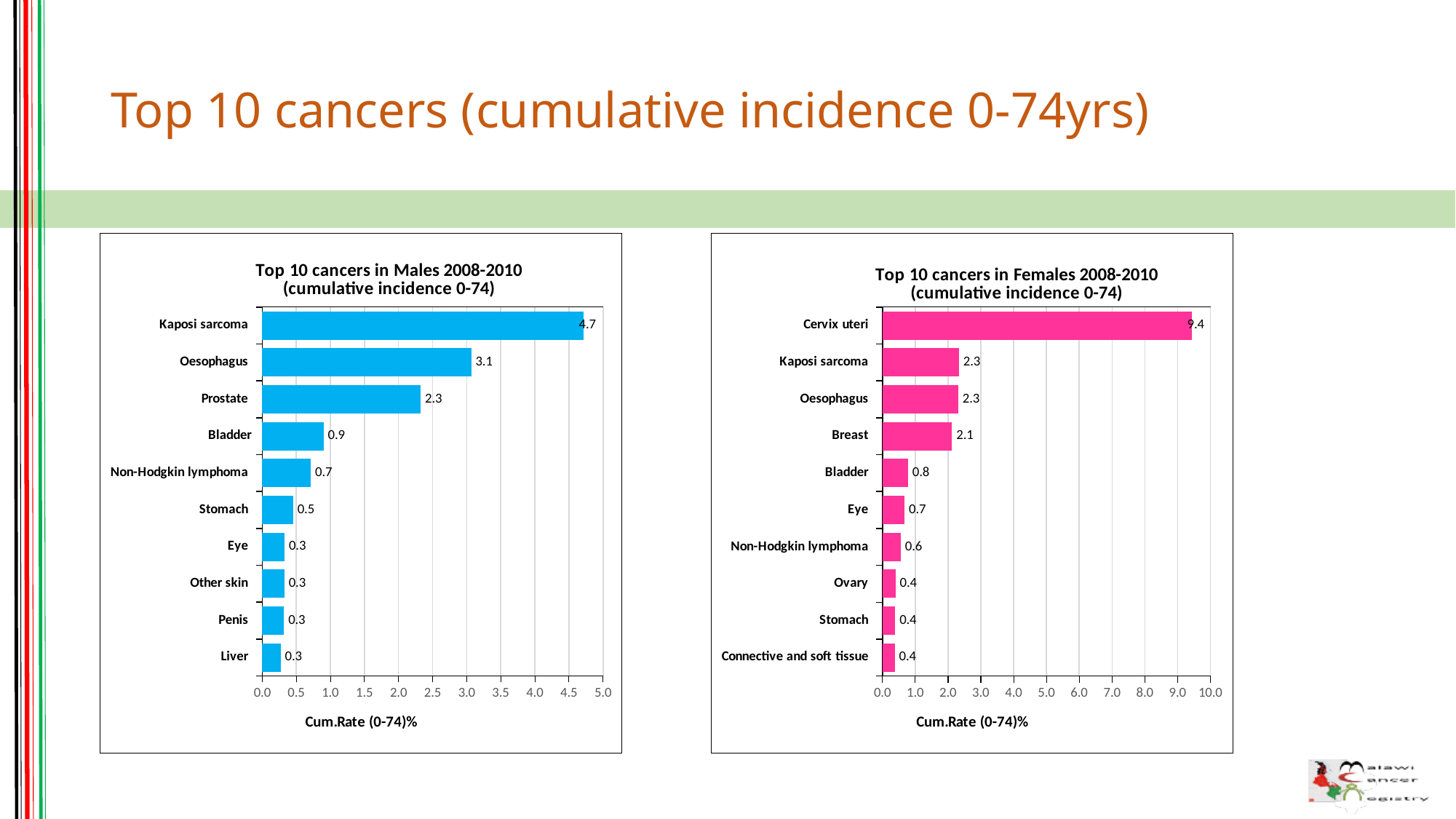
How many cancer categories are shown in the 'Top 10 cancers in Males 2008-2010' chart? 10 In the 'Top 10 cancers in Males 2008-2010' chart, which cancer has the highest cumulative rate? Kaposi sarcoma What kind of chart is the 'Top 10 cancers in Females 2008-2010' chart? Bar chart In the 'Top 10 cancers in Females 2008-2010' chart, what is the value for Cervix uteri? 9.4 In the 'Top 10 cancers in Males 2008-2010' chart, what is the value for Oesophagus? 3.1 In the 'Top 10 cancers in Females 2008-2010' chart, what is the difference between the values for Cervix uteri and Breast? 7.3 What is the x-axis label of the 'Top 10 cancers in Males 2008-2010' chart? Cum.Rate (0-74)% In the 'Top 10 cancers in Males 2008-2010' chart, what is the difference between the values for Kaposi sarcoma and Prostate? 2.4 In the 'Top 10 cancers in Females 2008-2010' chart, which cancer has the highest cumulative rate? Cervix uteri In the 'Top 10 cancers in Females 2008-2010' chart, what is the value for Non-Hodgkin lymphoma? 0.6 In the 'Top 10 cancers in Males 2008-2010' chart, which is larger, the value for Bladder or the value for Stomach? Bladder In the 'Top 10 cancers in Females 2008-2010' chart, is the value for Cervix uteri greater or less than 9.0? greater